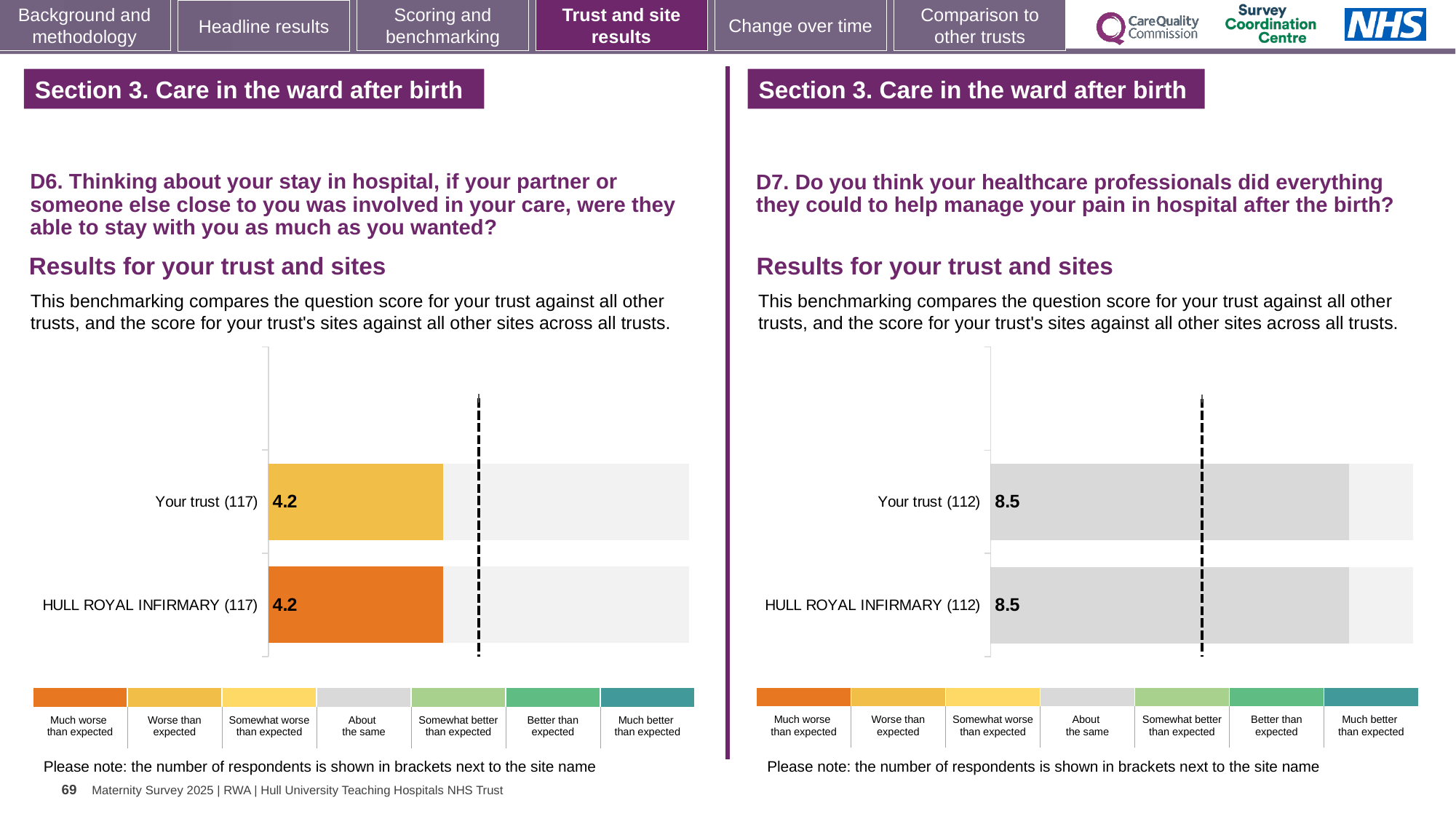
In the D7 chart on the right, how many respondents are shown in brackets for HULL ROYAL INFIRMARY? 112 What kind of chart is used for the D6 results on the left? Bar chart In the D7 chart on the right, what is the score for Your trust? 8.5 In the D6 chart on the left, how many respondents are shown in brackets for Your trust? 117 In the D7 chart on the right, which benchmark category does the grey colour of the Your trust bar correspond to in the legend? About the same In the D6 chart on the left, what is the score for Your trust? 4.2 In the D6 chart on the left, what is the difference between the score for Your trust and the score for HULL ROYAL INFIRMARY? 0 In the D7 chart on the right, what is the score for HULL ROYAL INFIRMARY? 8.5 In the D7 chart on the right, what is the difference between the score for Your trust and the score for HULL ROYAL INFIRMARY? 0 How many bars are plotted in the D6 chart on the left? 2 How many bars are plotted in the D7 chart on the right? 2 In the D6 chart on the left, what is the score for HULL ROYAL INFIRMARY? 4.2